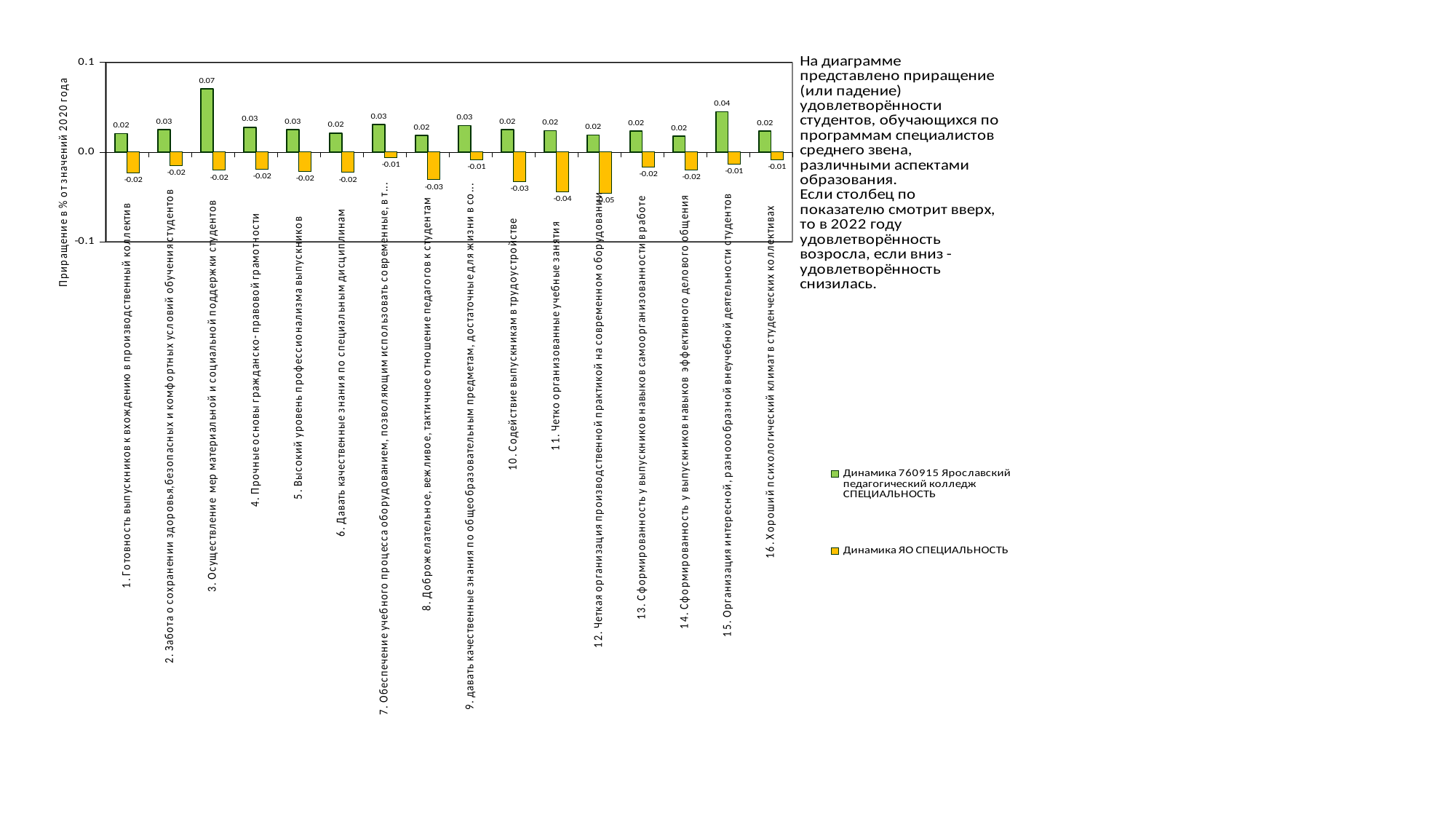
What is the difference between the green and yellow values for category 3 (Осуществление мер материальной и социальной поддержки студентов)? 0.09 What is the value of the green series for category 15 (Организация интересной, разнообразной внеучебной деятельности студентов)? 0.04 In the green series, which is larger: the value for category 3 or the value for category 15? Category 3 Which category has the lowest value in the yellow series (Динамика ЯО СПЕЦИАЛЬНОСТЬ)? 12. Четкая организация производственной практикой на современном оборудовании How many categories are shown on the x axis of the chart? 16 What is the value of the yellow series for category 11 (Четко организованные учебные занятия)? -0.04 What kind of chart is shown on the slide? Bar chart Which colour represents the series Динамика ЯО СПЕЦИАЛЬНОСТЬ in the legend? Yellow What is the value of the green series (Динамика 760915 Ярославский педагогический колледж СПЕЦИАЛЬНОСТЬ) for category 3 (Осуществление мер материальной и социальной поддержки студентов)? 0.07 Which category has the highest value in the green series (Динамика 760915 Ярославский педагогический колледж СПЕЦИАЛЬНОСТЬ)? 3. Осуществление мер материальной и социальной поддержки студентов What is the value of the yellow series (Динамика ЯО СПЕЦИАЛЬНОСТЬ) for category 12 (Четкая организация производственной практикой на современном оборудовании)? -0.05 How many series does the legend list? 2